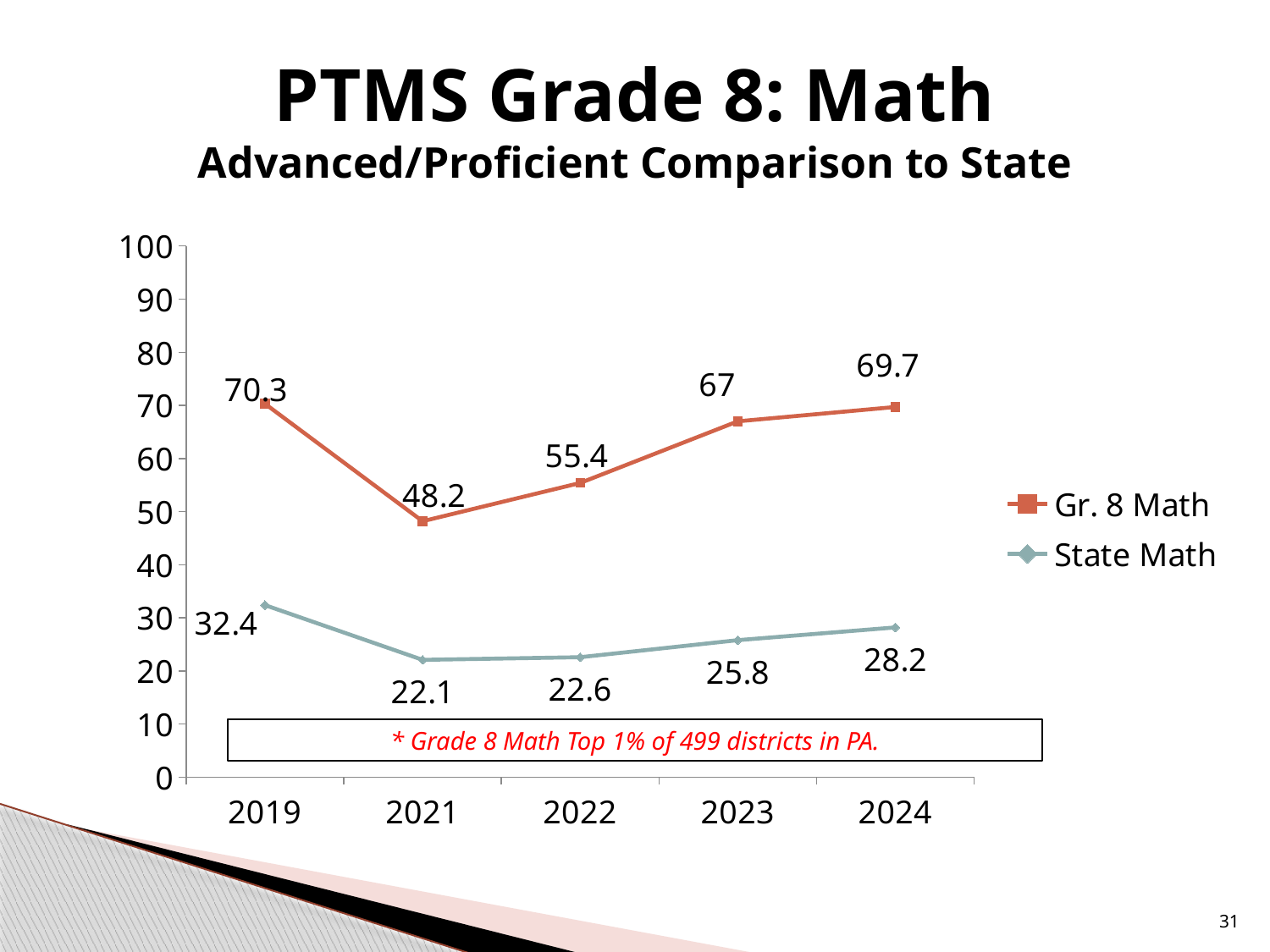
In which year is the Gr. 8 Math value highest? 2019 What kind of chart is shown on the slide? line chart What is the difference between the Gr. 8 Math and State Math values in 2024? 41.5 Which is larger in 2022: the Gr. 8 Math value or the State Math value? Gr. 8 Math In which year is the State Math value lowest? 2021 What is the State Math value for 2023? 25.8 How many years are shown on the x axis? 5 What is the Gr. 8 Math value for 2024? 69.7 Is the Gr. 8 Math value for 2023 greater or less than 60? greater What is the Gr. 8 Math value for 2021? 48.2 Does the Gr. 8 Math value rise or fall from 2021 to 2024? rise How many series does the legend list? 2